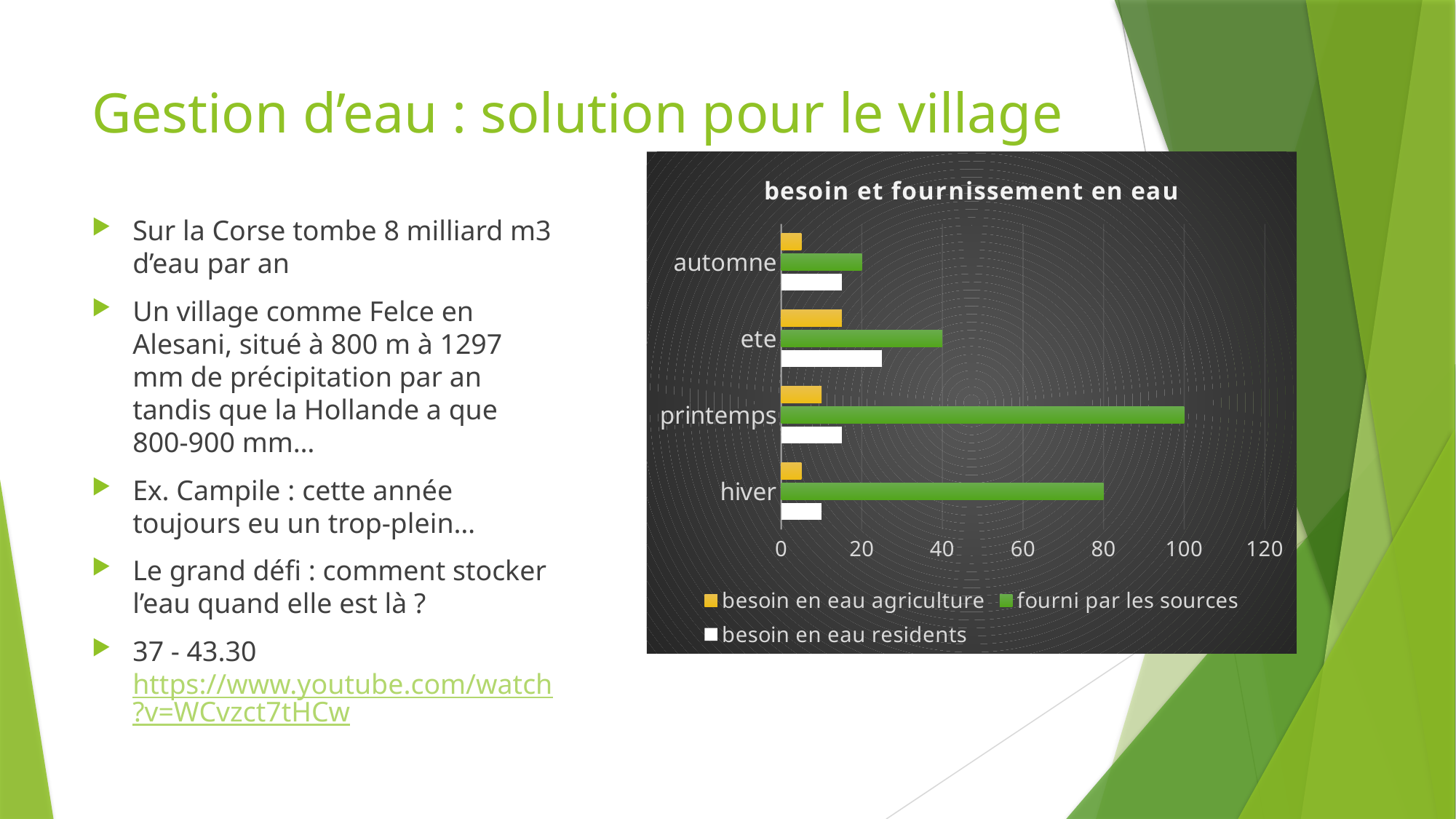
Is the value of 'besoin en eau residents' for ete greater or less than 40? less What is the title of the chart? besoin et fournissement en eau How many seasons (categories) are shown on the chart? 4 What is the difference between 'fourni par les sources' for printemps and for hiver? 20 How many series does the chart legend list? 3 What kind of chart is shown on the slide? bar chart Which season has the highest value for 'fourni par les sources'? printemps Which is larger for ete: 'fourni par les sources' or 'besoin en eau residents'? fourni par les sources What is the value of 'fourni par les sources' for printemps? 100 What is the value of 'fourni par les sources' for hiver? 80 Which colour represents 'besoin en eau agriculture' in the chart? yellow Which season has the lowest value for 'fourni par les sources'? automne